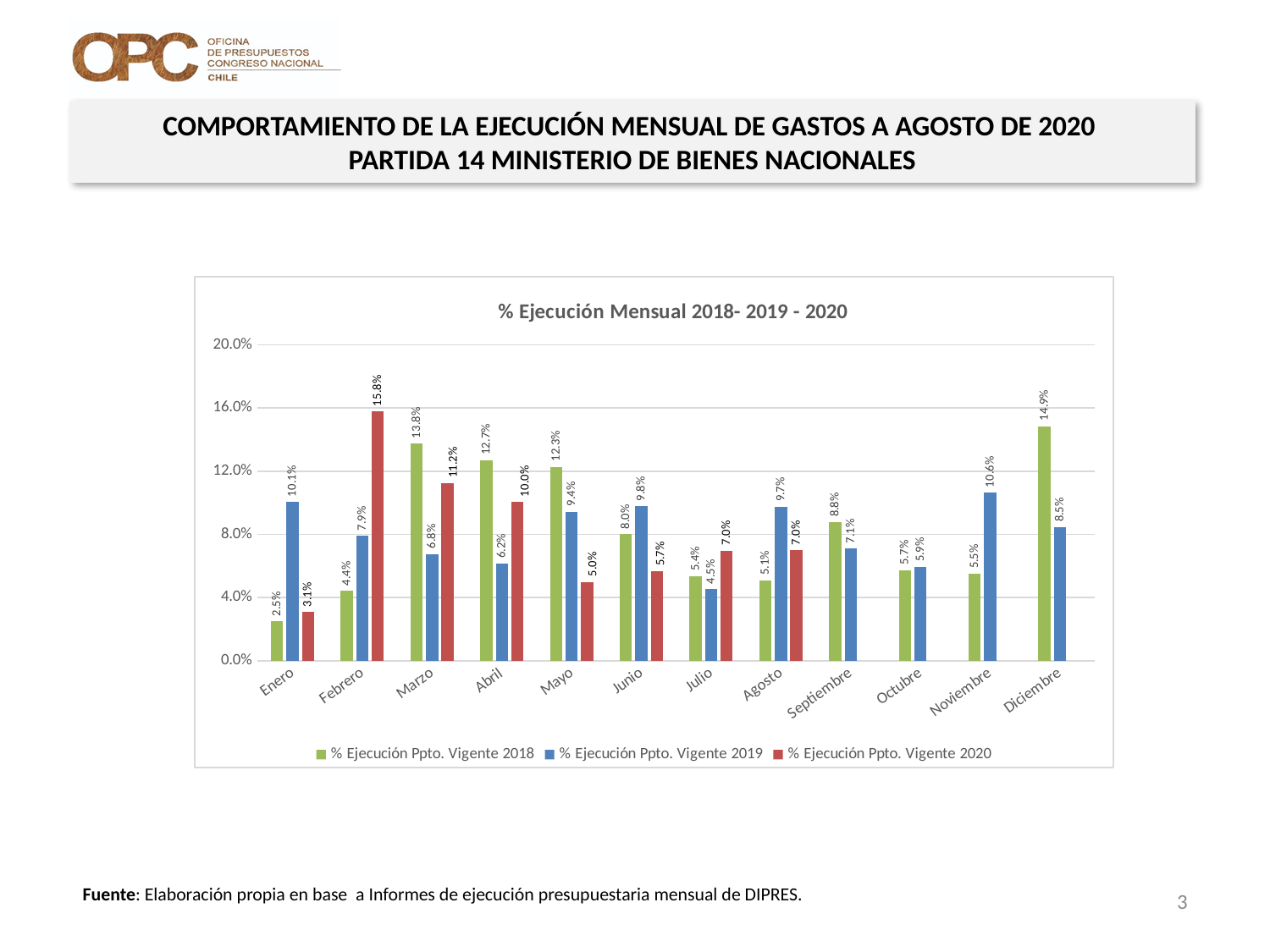
What is the difference between the 2018 and 2019 values for Marzo? 7.0% What is the title of the chart? % Ejecución Mensual 2018- 2019 - 2020 Which month has the lowest value for % Ejecución Ppto. Vigente 2018? Enero What is the value of % Ejecución Ppto. Vigente 2018 for Diciembre? 14.9% What type of chart is shown on the slide? Bar chart How many series does the legend list? 3 Is the 2018 value for Mayo greater or less than 12.0%? greater Which is larger in Enero: the 2019 value or the 2020 value? 2019 value (10.1%) How many months are shown on the x axis? 12 What is the value of % Ejecución Ppto. Vigente 2019 for Noviembre? 10.6% Which month has the highest value for % Ejecución Ppto. Vigente 2020? Febrero What is the value of % Ejecución Ppto. Vigente 2020 for Febrero? 15.8%